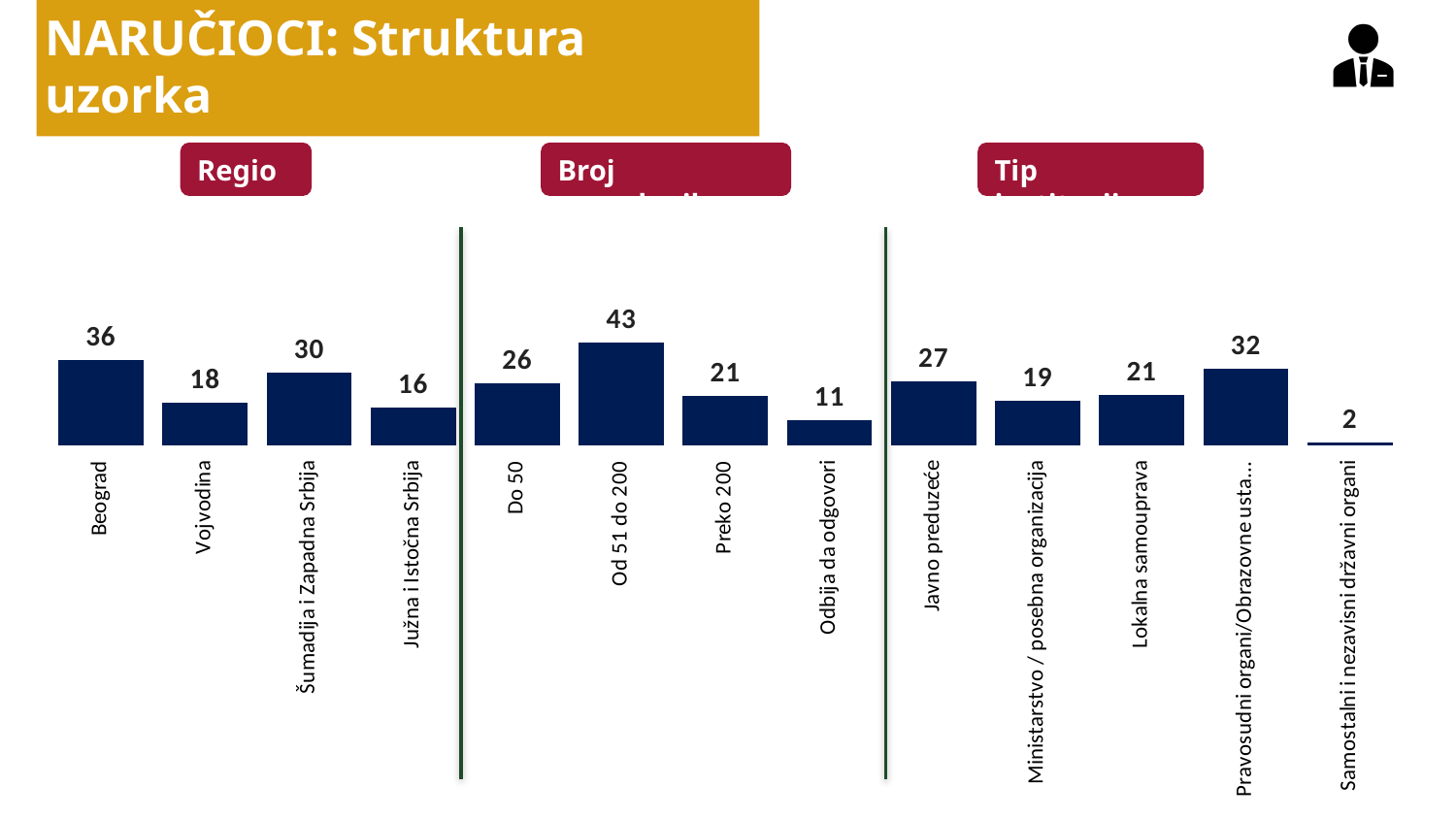
Which category has the highest value on the chart? Od 51 do 200 Which is larger, the value for Do 50 or the value for Preko 200? Do 50 What is the label of the first red section header above the chart? Regio What is the value for Javno preduzeće? 27 What is the value for Od 51 do 200? 43 What is the value for Beograd? 36 What is the difference between the values for Beograd and Vojvodina? 18 What is the difference between the values for Lokalna samouprava and Ministarstvo / posebna organizacija? 2 What is the value for Samostalni i nezavisni državni organi? 2 How many bars are shown on the chart? 13 What kind of chart is shown on the slide? Bar chart Which category has the lowest value on the chart? Samostalni i nezavisni državni organi